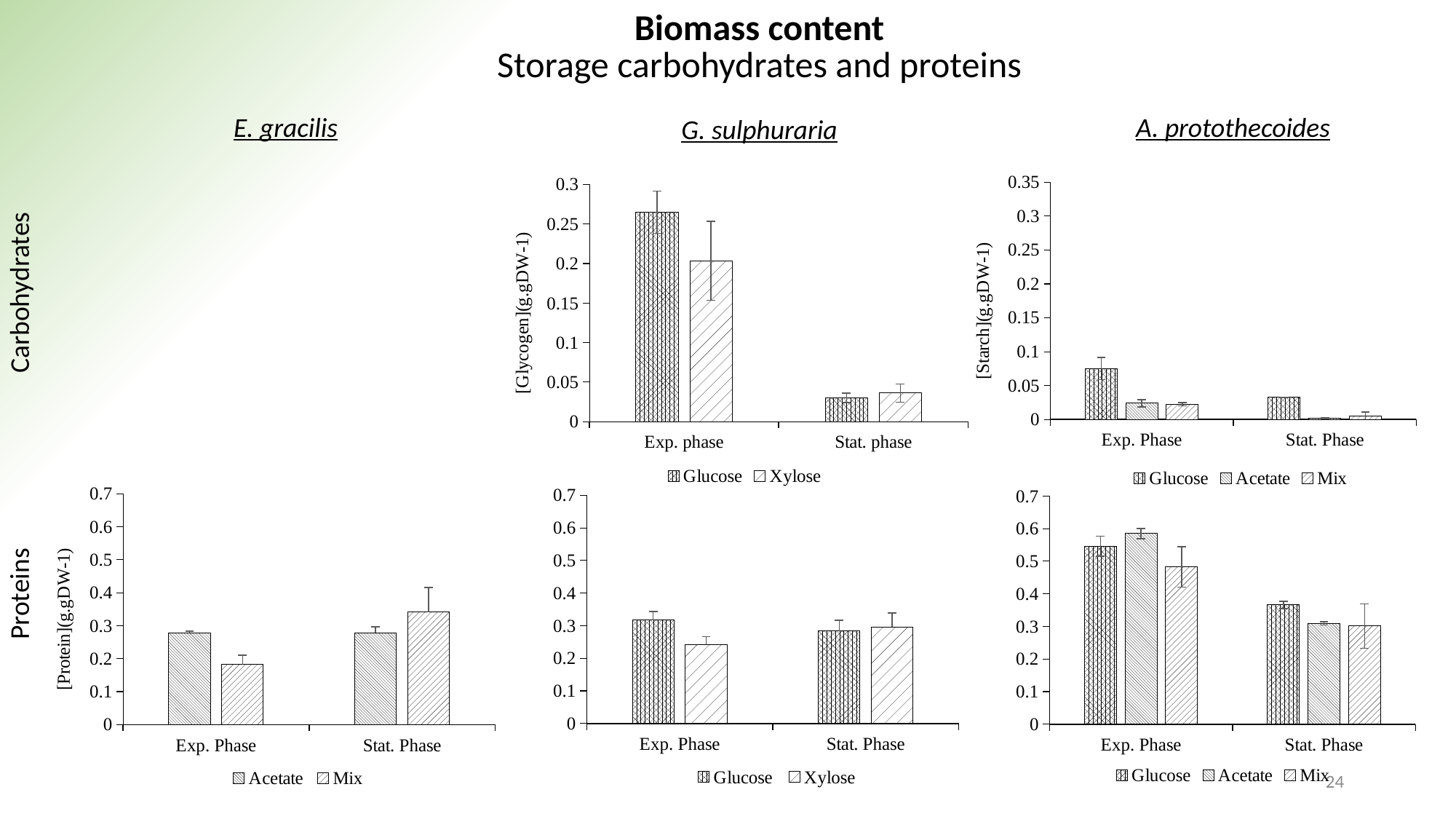
In the G. sulphuraria carbohydrates chart (top middle), which phase has the higher Glucose value, Exp. phase or Stat. phase? Exp. phase In the A. protothecoides proteins chart (bottom right), which series has the highest value in the Exp. Phase? Acetate In the G. sulphuraria carbohydrates chart (top middle), how many series does the legend list? 2 In the E. gracilis proteins chart (bottom left), how many series does the legend list? 2 In the A. protothecoides proteins chart (bottom right), is the Glucose value in the Exp. Phase greater or less than 0.5? greater In the A. protothecoides carbohydrates chart (top right), which series has the highest value in the Exp. Phase? Glucose In the G. sulphuraria carbohydrates chart (top middle), is the Glucose value in the Exp. phase greater or less than 0.2? greater In the E. gracilis proteins chart (bottom left), is the Mix value in the Stat. Phase greater or less than 0.3? greater What is the y-axis label of the A. protothecoides carbohydrates chart (top right)? [Starch](g.gDW-1) In the E. gracilis proteins chart (bottom left), which is larger in the Stat. Phase, Acetate or Mix? Mix